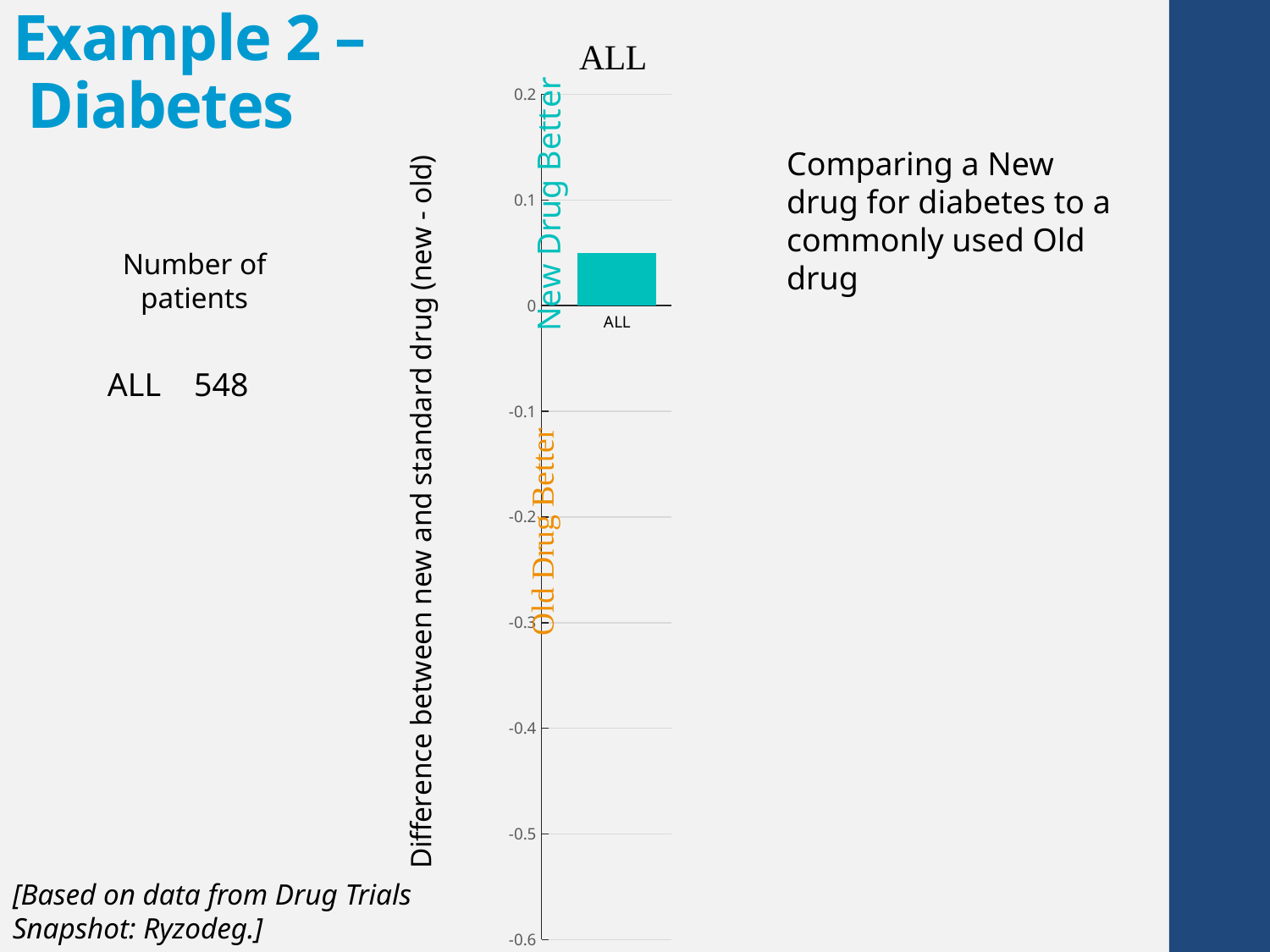
What is the title of the chart? ALL What is the label on the vertical axis of the chart? Difference between new and standard drug (new - old) What is the lowest tick value shown on the vertical axis? -0.6 Is the value for ALL greater or less than -0.1? greater Is the value for ALL greater or less than 0.1? less How many bars are plotted in the chart? 1 Is the value for ALL greater or less than 0? greater What kind of chart is shown on the slide? bar chart